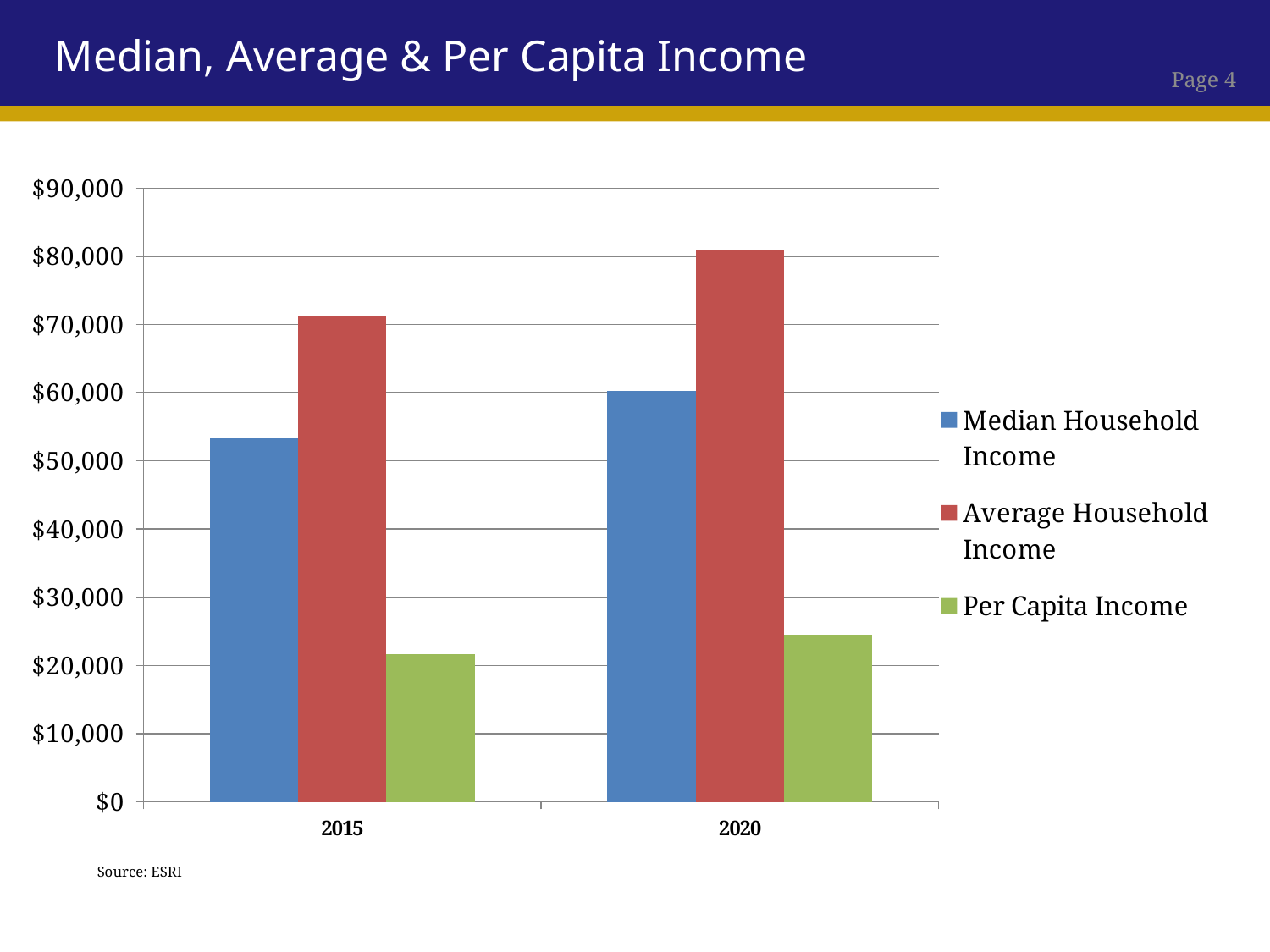
Which is larger, the Median Household Income for 2015 or for 2020? 2020 Is the Average Household Income for 2020 greater or less than $70,000? greater How many series does the legend list? 3 What kind of chart is shown on the slide? Bar chart Is the Per Capita Income for 2015 greater or less than $20,000? greater How many year categories are shown on the x axis? 2 Is the Median Household Income for 2015 greater or less than $50,000? greater Do the Average Household Income values rise or fall from 2015 to 2020? rise Which series and year has the shortest bar? Per Capita Income, 2015 Which series and year has the tallest bar? Average Household Income, 2020